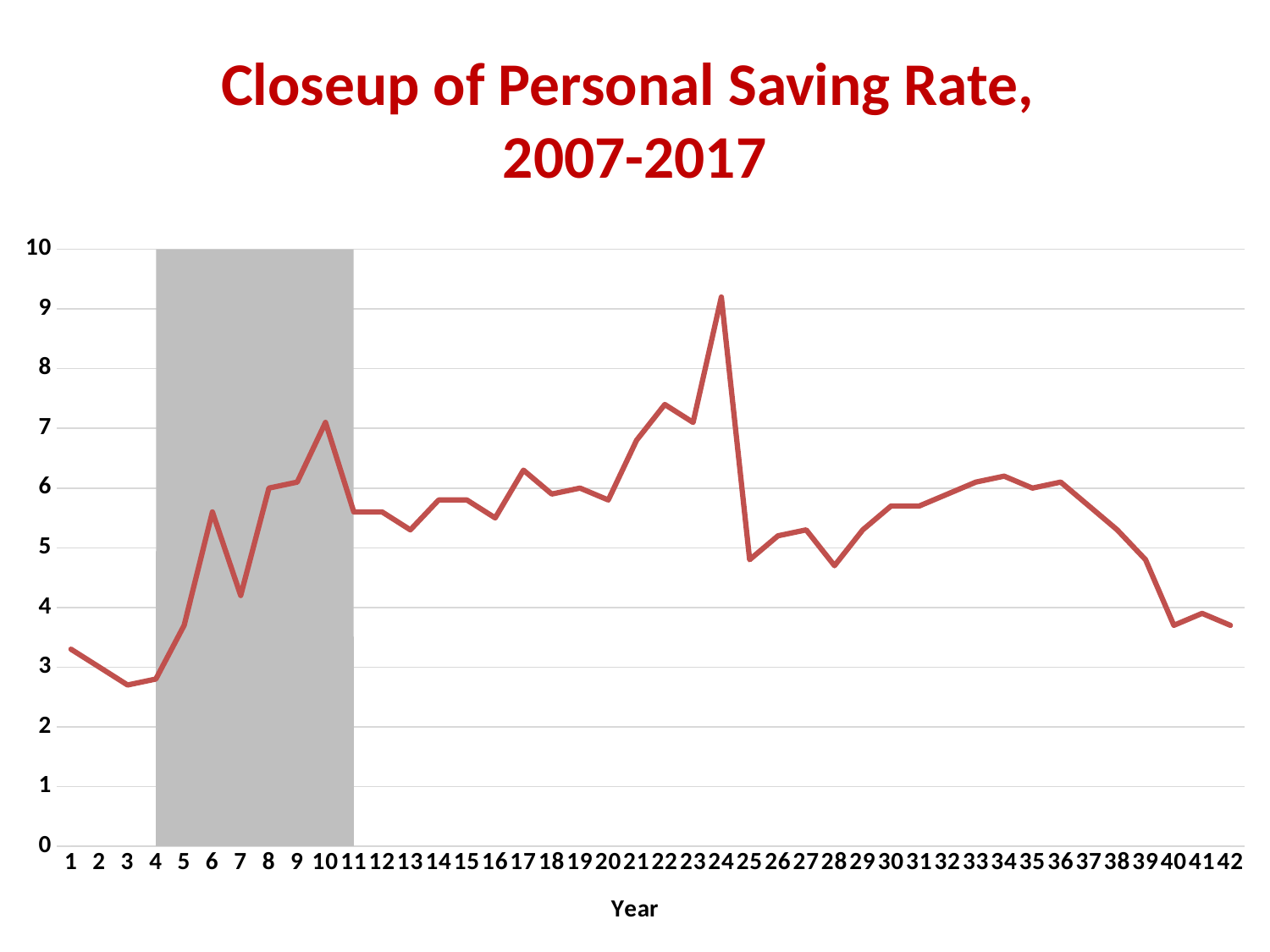
What kind of chart is shown on the slide? line chart Which is larger, the value at point 22 or the value at point 28? point 22 At which x-axis point does the line reach its highest value? 24 Is the value at point 3 greater or less than 3? less How many data points are plotted along the x axis? 42 What is the title of the chart? Closeup of Personal Saving Rate, 2007-2017 Is the value at point 7 greater or less than 5? less What is the label of the x axis? Year Is the value at point 24 greater or less than 8? greater At which x-axis point does the line reach its lowest value? 3 Does the line rise or fall between point 36 and point 40? fall